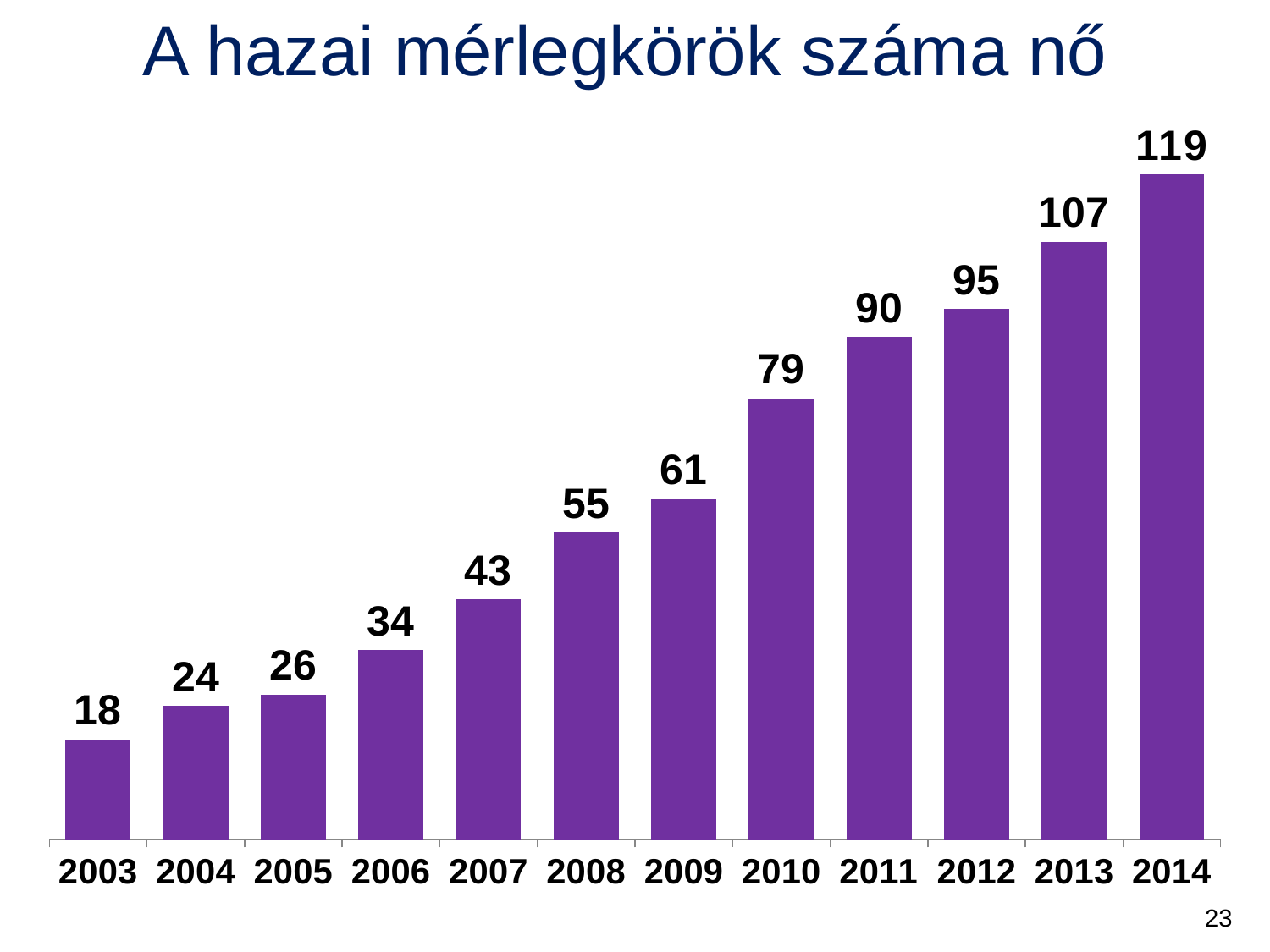
Do the values rise or fall from 2003 to 2014? rise What is the value for 2003? 18 How many years are shown on the x axis? 12 What is the title of the slide? A hazai mérlegkörök száma nő What is the difference between the values for 2014 and 2013? 12 What is the difference between the values for 2009 and 2008? 6 Which year has the highest value? 2014 Which year has the lowest value? 2003 What is the value for 2010? 79 What kind of chart is shown on the slide? bar chart Which is larger, the value for 2007 or the value for 2006? 2007 What is the value for 2014? 119